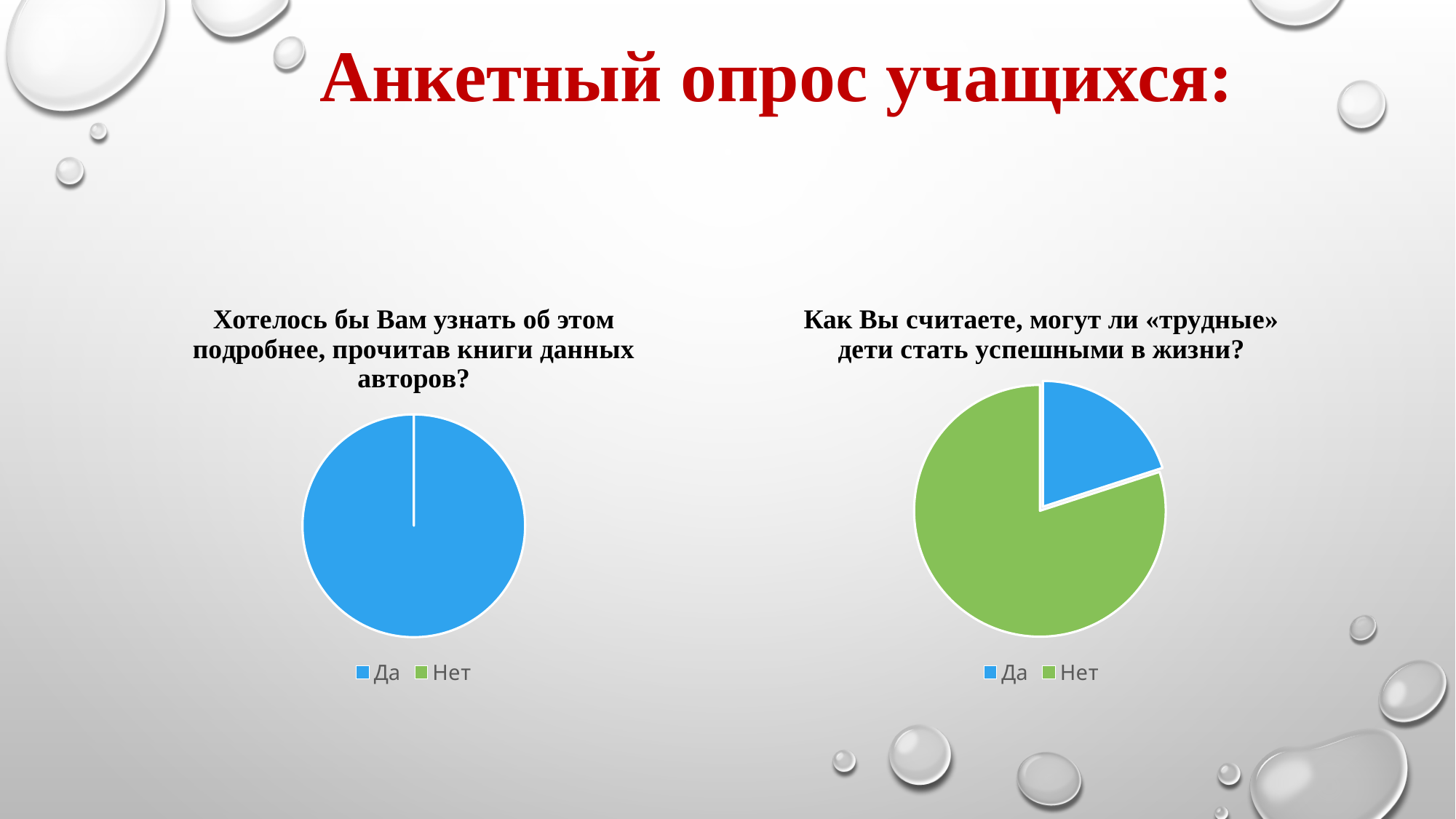
What kind of chart is the right chart titled "Как Вы считаете, могут ли «трудные» дети стать успешными в жизни?"? pie chart In the left chart, is the slice for Да larger or smaller than the slice for Нет? larger How many entries does the legend of the right chart list? 2 How many charts are shown on the slide? 2 In the left chart ("Хотелось бы Вам узнать об этом подробнее, прочитав книги данных авторов?"), which answer has the largest slice? Да In the right chart, is the slice for Да larger or smaller than the slice for Нет? smaller In the right chart ("Как Вы считаете, могут ли «трудные» дети стать успешными в жизни?"), which answer has the smallest slice? Да What kind of chart is the left chart titled "Хотелось бы Вам узнать об этом подробнее, прочитав книги данных авторов?"? pie chart What is the title of the left chart? Хотелось бы Вам узнать об этом подробнее, прочитав книги данных авторов? How many entries does the legend of the left chart list? 2 What colour represents the answer Нет in the legend of the right chart? green In the right chart ("Как Вы считаете, могут ли «трудные» дети стать успешными в жизни?"), which answer has the largest slice? Нет